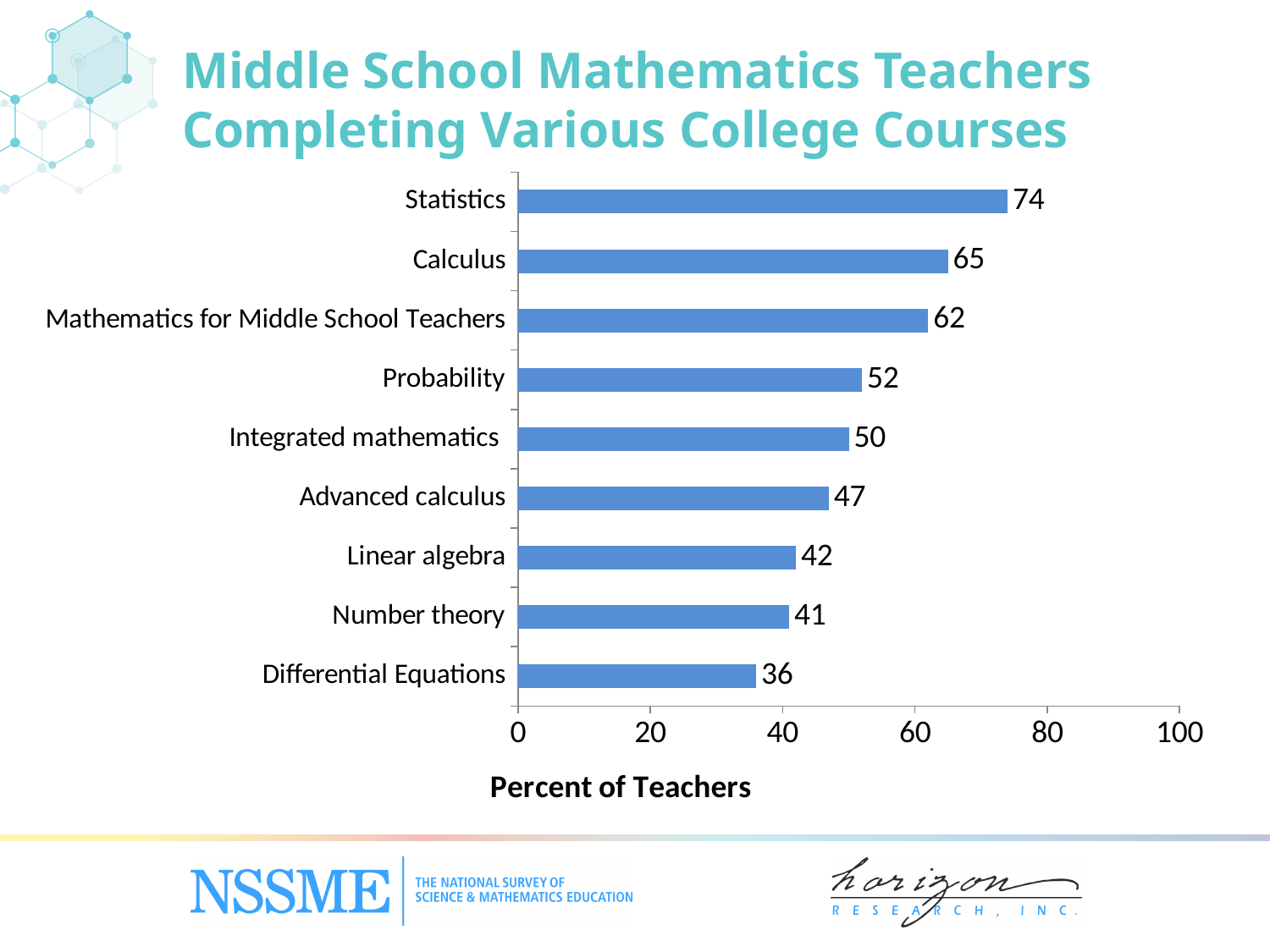
What is the difference between the values for Number theory and Differential Equations? 5 What is the difference between the values for Calculus and Advanced calculus? 18 Which is larger, the value for Linear algebra or the value for Integrated mathematics? Integrated mathematics How many courses are shown in the chart? 9 What is the value for Probability? 52 Which course has the highest percent of teachers? Statistics What is the value for Differential Equations? 36 What percent of middle school mathematics teachers completed a Statistics course? 74 What is the label of the horizontal axis? Percent of Teachers Which course has the lowest percent of teachers? Differential Equations Is the value for Mathematics for Middle School Teachers greater or less than 60? greater What kind of chart is shown on the slide? Bar chart